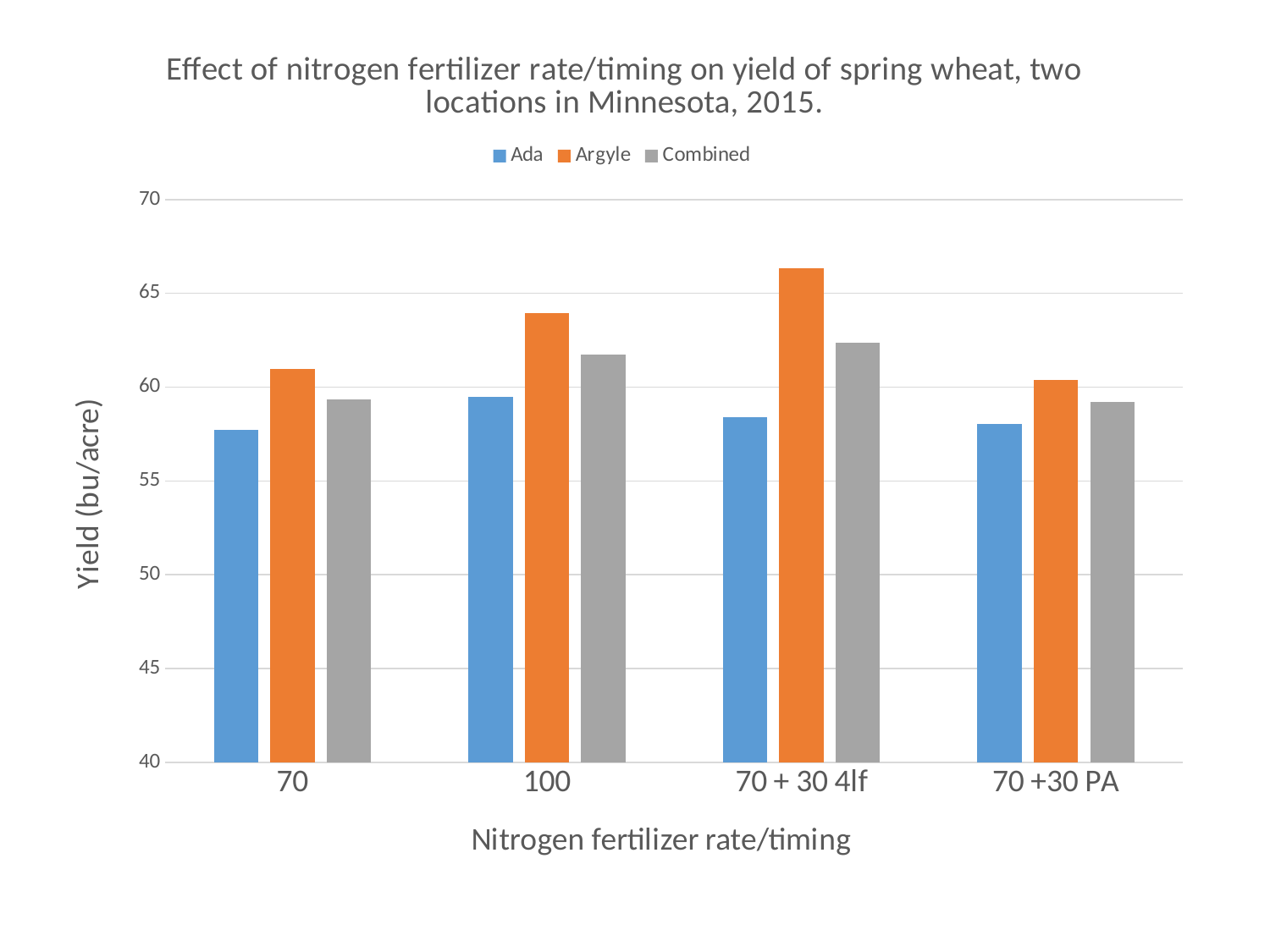
For which nitrogen fertilizer rate/timing is the Argyle yield highest? 70 + 30 4lf How many nitrogen fertilizer rate/timing categories are shown on the x axis? 4 Is the Argyle yield for 70 + 30 4lf greater or less than 65? greater What is the label of the y axis? Yield (bu/acre) Is the Argyle yield for 100 greater or less than 65? less What kind of chart is shown on the slide? bar chart For which nitrogen fertilizer rate/timing is the Ada yield highest? 100 How many series does the legend list? 3 Is the Ada yield for 70 greater or less than 60? less Which is larger at the 100 rate, the Ada yield or the Argyle yield? Argyle Which is larger for the Combined series, the yield at 70 or the yield at 100? 100